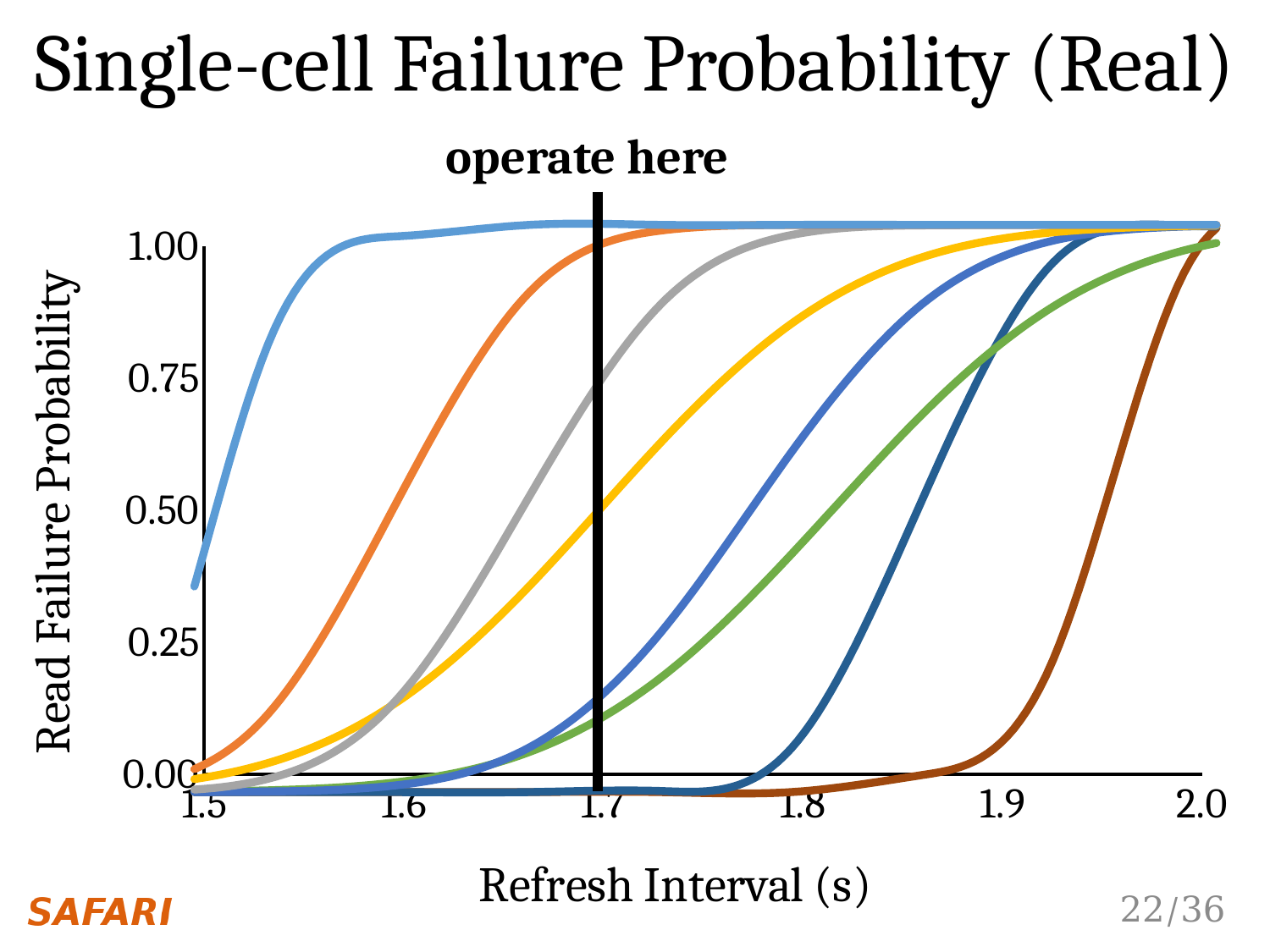
What kind of chart is shown on the slide? line chart Is the value of the green curve at a refresh interval of 1.7 s greater or less than 0.25? less What is the label of the x axis? Refresh Interval (s) Which curve reaches a read failure probability of 1.00 at the lowest refresh interval? light blue curve Is the value of the orange curve at a refresh interval of 1.7 s greater or less than 0.75? greater How many curves are plotted on the chart? 8 At what refresh interval is the vertical 'operate here' line drawn? 1.7 Do the curves rise or fall as the refresh interval increases? rise At a refresh interval of 1.8 s, which curve has the higher read failure probability, the yellow curve or the brown curve? yellow curve What is the label of the y axis? Read Failure Probability Is the value of the brown curve at a refresh interval of 1.9 s greater or less than 0.25? less